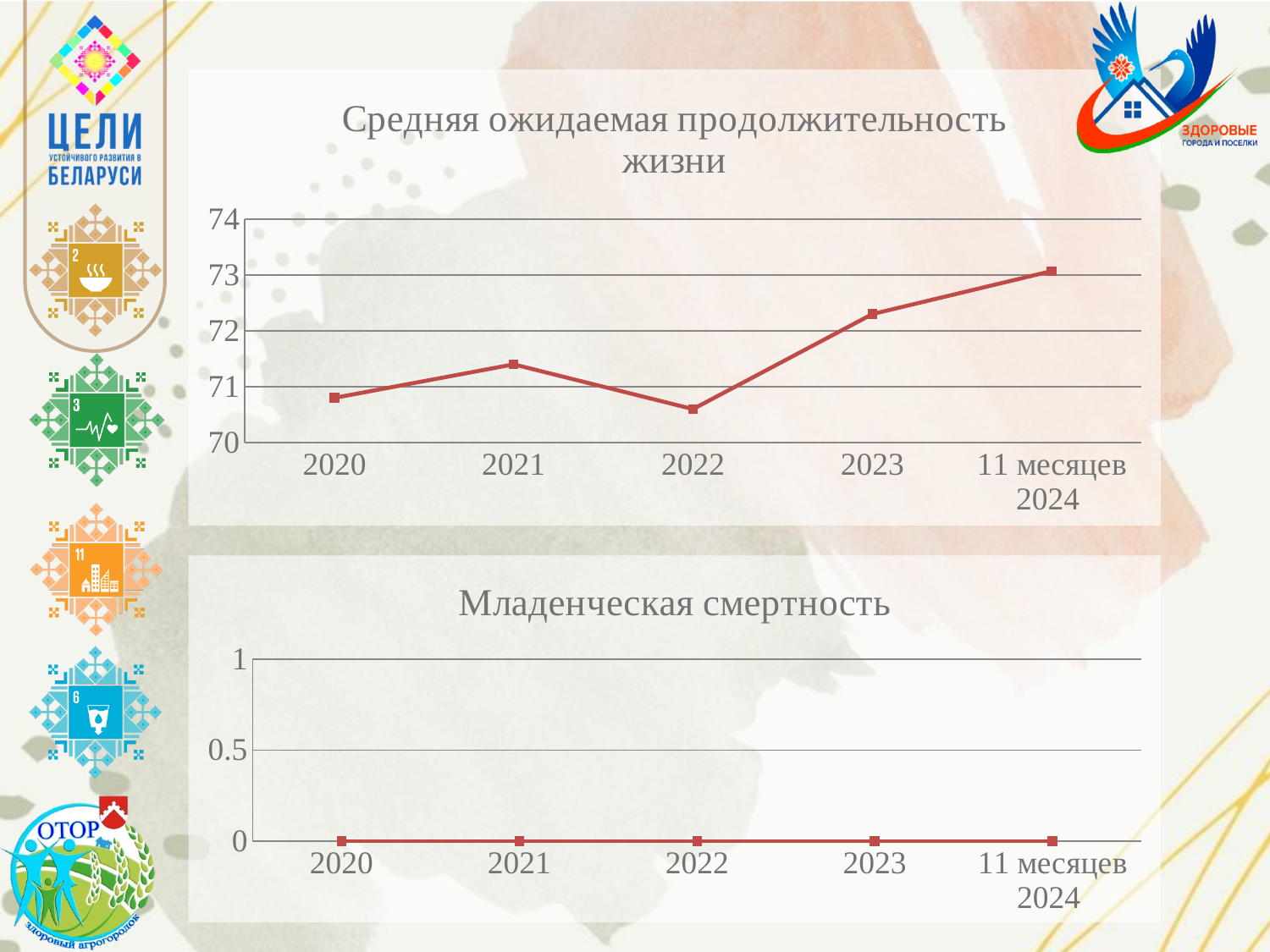
In the top chart "Средняя ожидаемая продолжительность жизни", do the values rise or fall from 2022 to 11 месяцев 2024? rise In the top chart "Средняя ожидаемая продолжительность жизни", which year has the lowest value? 2022 What is the title of the bottom chart on the slide? Младенческая смертность In the top chart "Средняя ожидаемая продолжительность жизни", is the value for 2020 greater or less than 71? less In the top chart "Средняя ожидаемая продолжительность жизни", is the value for 2023 greater or less than 72? greater In the top chart "Средняя ожидаемая продолжительность жизни", how many data points are plotted? 5 In the top chart "Средняя ожидаемая продолжительность жизни", which is larger, the value for 2021 or the value for 2022? 2021 In the bottom chart "Младенческая смертность", what is the value for 2023? 0 In the bottom chart "Младенческая смертность", how many periods are shown on the x axis? 5 What kind of chart is the top chart titled "Средняя ожидаемая продолжительность жизни"? line chart In the top chart "Средняя ожидаемая продолжительность жизни", which period has the highest value? 11 месяцев 2024